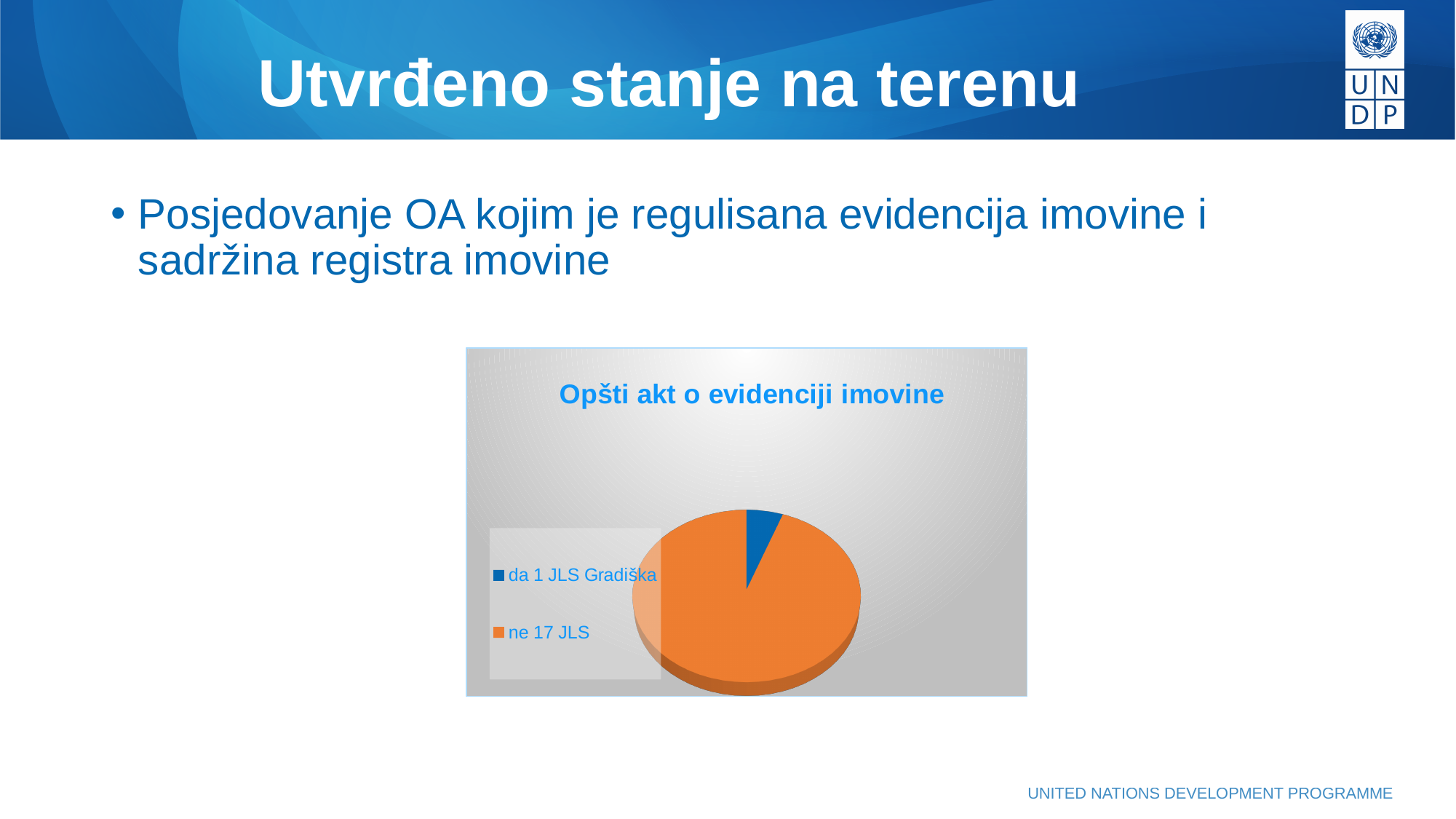
According to the legend, how many JLS answered 'da'? 1 What is the title of the chart? Opšti akt o evidenciji imovine What kind of chart is shown on the slide? pie chart Which JLS is named in the legend as having answered 'da'? Gradiška What is the difference between the number of JLS that answered 'ne' and those that answered 'da'? 16 How many entries does the chart legend list? 2 According to the legend, how many JLS answered 'ne'? 17 Which category has the largest slice of the pie? ne 17 JLS How many slices does the pie chart have? 2 Which category has the smallest slice of the pie? da 1 JLS Gradiška Which category has the larger slice of the pie, 'da' or 'ne'? ne